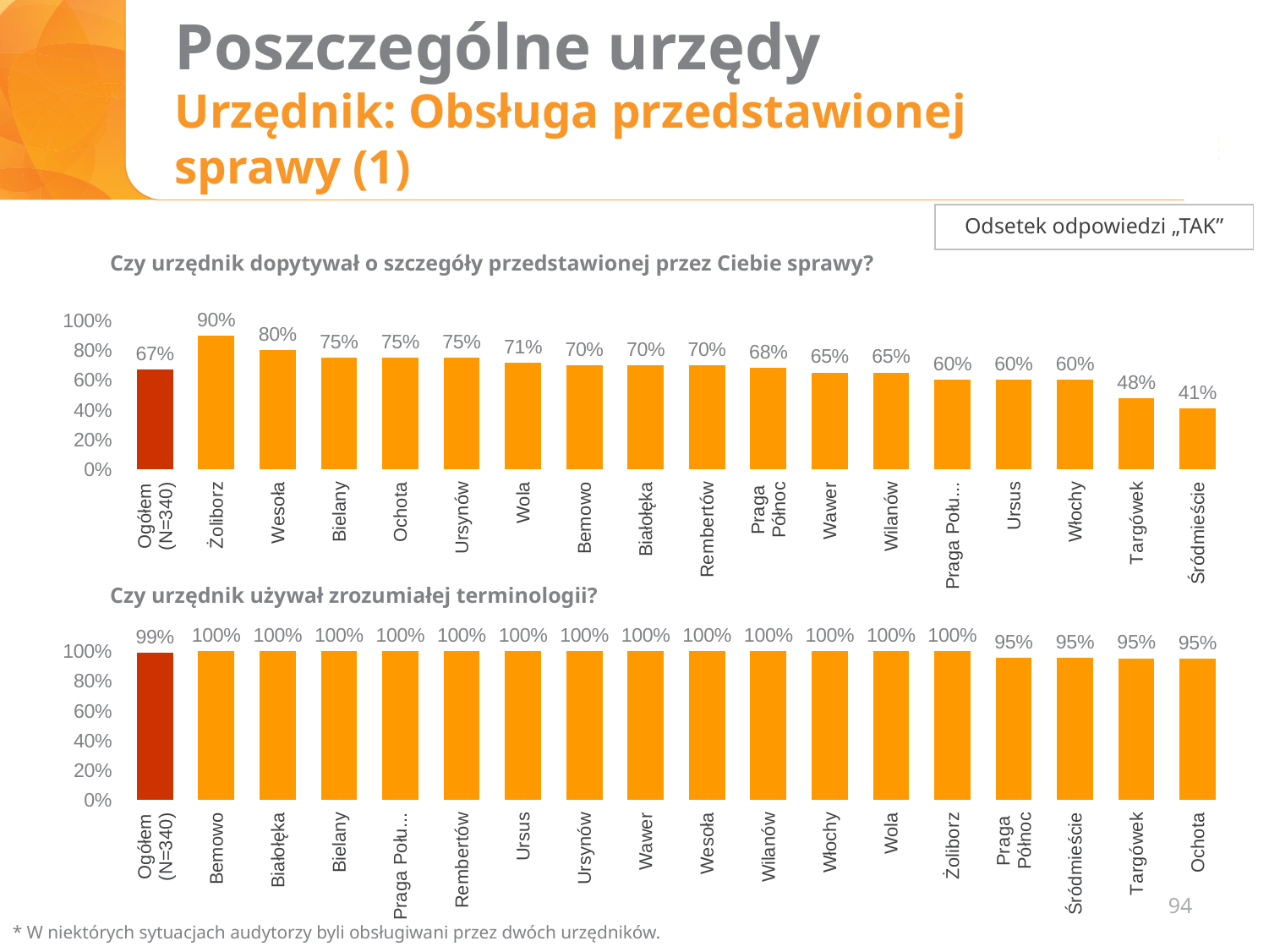
In the top chart ("Czy urzędnik dopytywał o szczegóły przedstawionej przez Ciebie sprawy?"), which district has the lowest value? Śródmieście In the top chart ("Czy urzędnik dopytywał o szczegóły przedstawionej przez Ciebie sprawy?"), what is the difference between Żoliborz and Targówek? 42% In the bottom chart ("Czy urzędnik używał zrozumiałej terminologii?"), what is the difference between Bemowo and Targówek? 5% In the top chart ("Czy urzędnik dopytywał o szczegóły przedstawionej przez Ciebie sprawy?"), do the values rise or fall from Żoliborz to Śródmieście along the x axis? Fall In the bottom chart ("Czy urzędnik używał zrozumiałej terminologii?"), what is the value for Ogółem (N=340)? 99% In the bottom chart ("Czy urzędnik używał zrozumiałej terminologii?"), what is the value for Ochota? 95% In the top chart ("Czy urzędnik dopytywał o szczegóły przedstawionej przez Ciebie sprawy?"), how many bars are plotted? 18 In the top chart ("Czy urzędnik dopytywał o szczegóły przedstawionej przez Ciebie sprawy?"), which district has the highest value? Żoliborz In the top chart ("Czy urzędnik dopytywał o szczegóły przedstawionej przez Ciebie sprawy?"), what is the value for Ogółem (N=340)? 67% In the top chart ("Czy urzędnik dopytywał o szczegóły przedstawionej przez Ciebie sprawy?"), what is the value for Żoliborz? 90% In the top chart ("Czy urzędnik dopytywał o szczegóły przedstawionej przez Ciebie sprawy?"), which is larger, Wesoła or Wola? Wesoła What type of chart is the bottom chart ("Czy urzędnik używał zrozumiałej terminologii?")? Bar chart